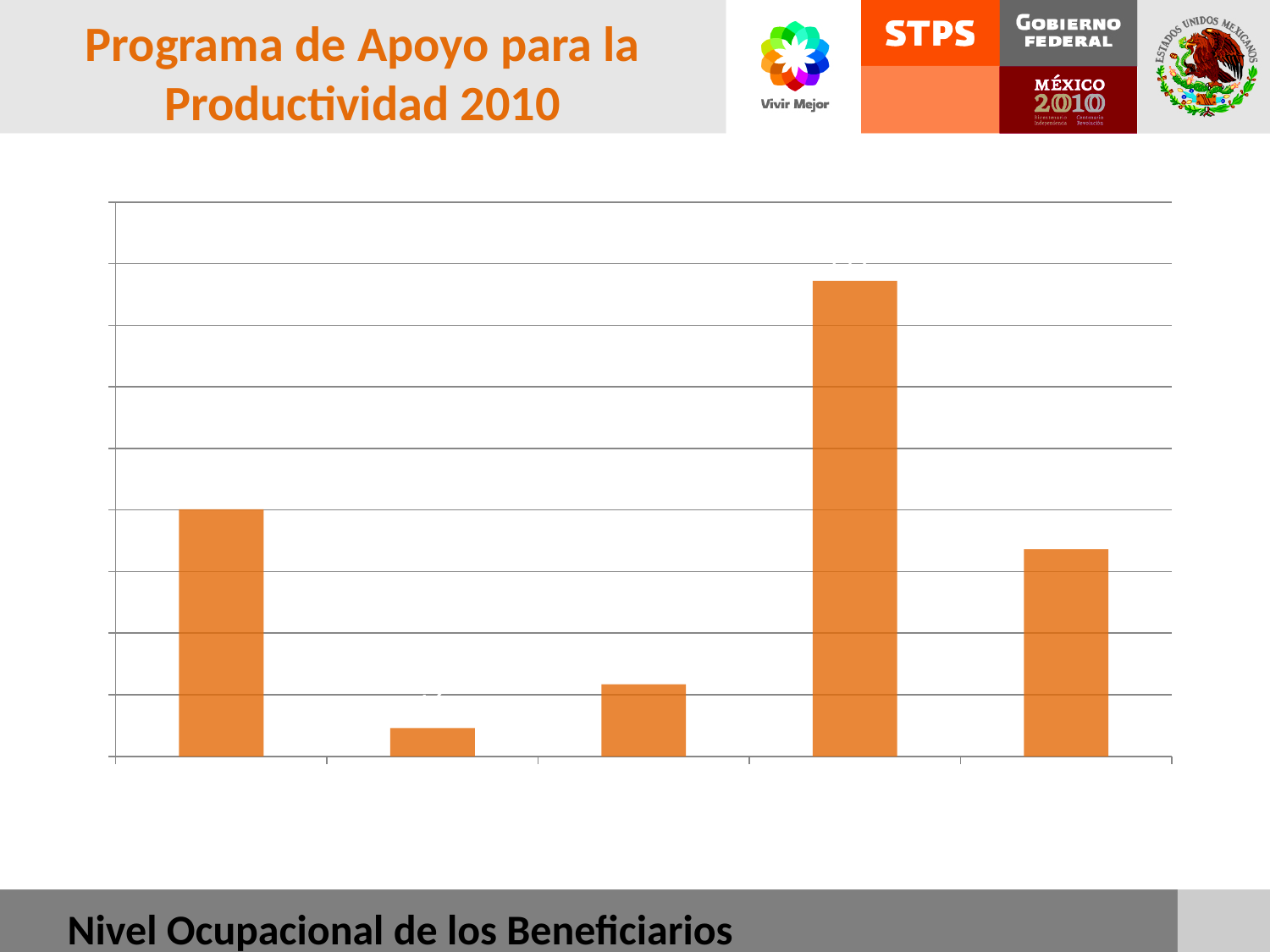
Which bar is the shortest in the chart, counting from the left? the second bar Which is taller, the first bar or the fifth bar? the first bar Which bar is the tallest in the chart, counting from the left? the fourth bar Which is taller, the third bar or the second bar? the third bar Which is taller, the fourth bar or the first bar? the fourth bar What caption appears in the bar at the bottom of the slide below the chart? Nivel Ocupacional de los Beneficiarios What colour are the bars in the chart? orange What kind of chart is shown on the slide? bar chart How many bars does the chart show? 5